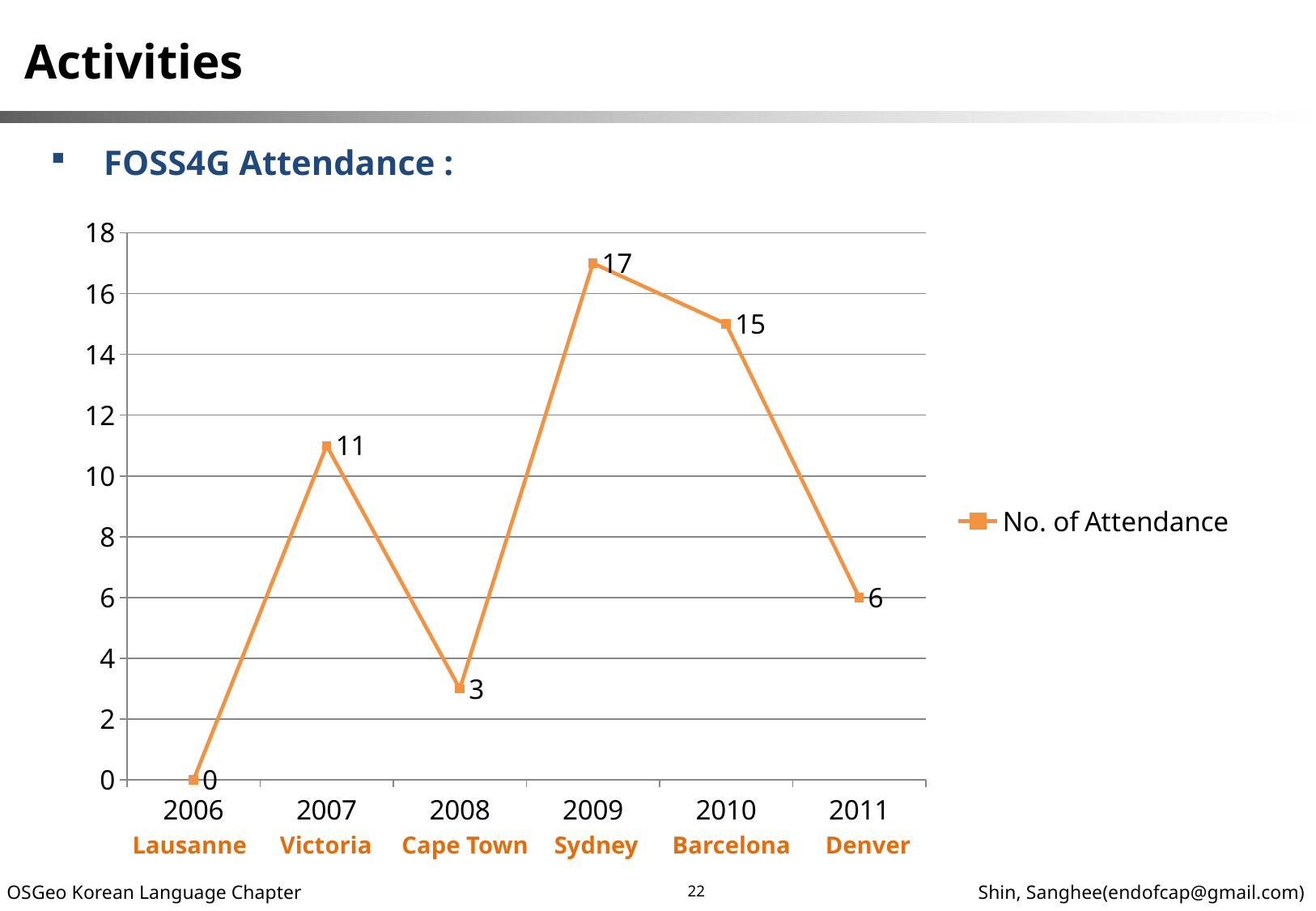
What is the number of attendance for 2009? 17 What is the number of attendance for 2007? 11 What is the difference in attendance between 2009 and 2010? 2 How many years are plotted on the chart? 6 How many series does the legend list? 1 Which year has the lowest number of attendance? 2006 What is the number of attendance for 2011? 6 What is the difference in attendance between 2007 and 2008? 8 Which city is labelled under the year 2008? Cape Town What kind of chart is shown on the slide? Line chart Which year has the highest number of attendance? 2009 Which year had more attendance, 2010 or 2011? 2010